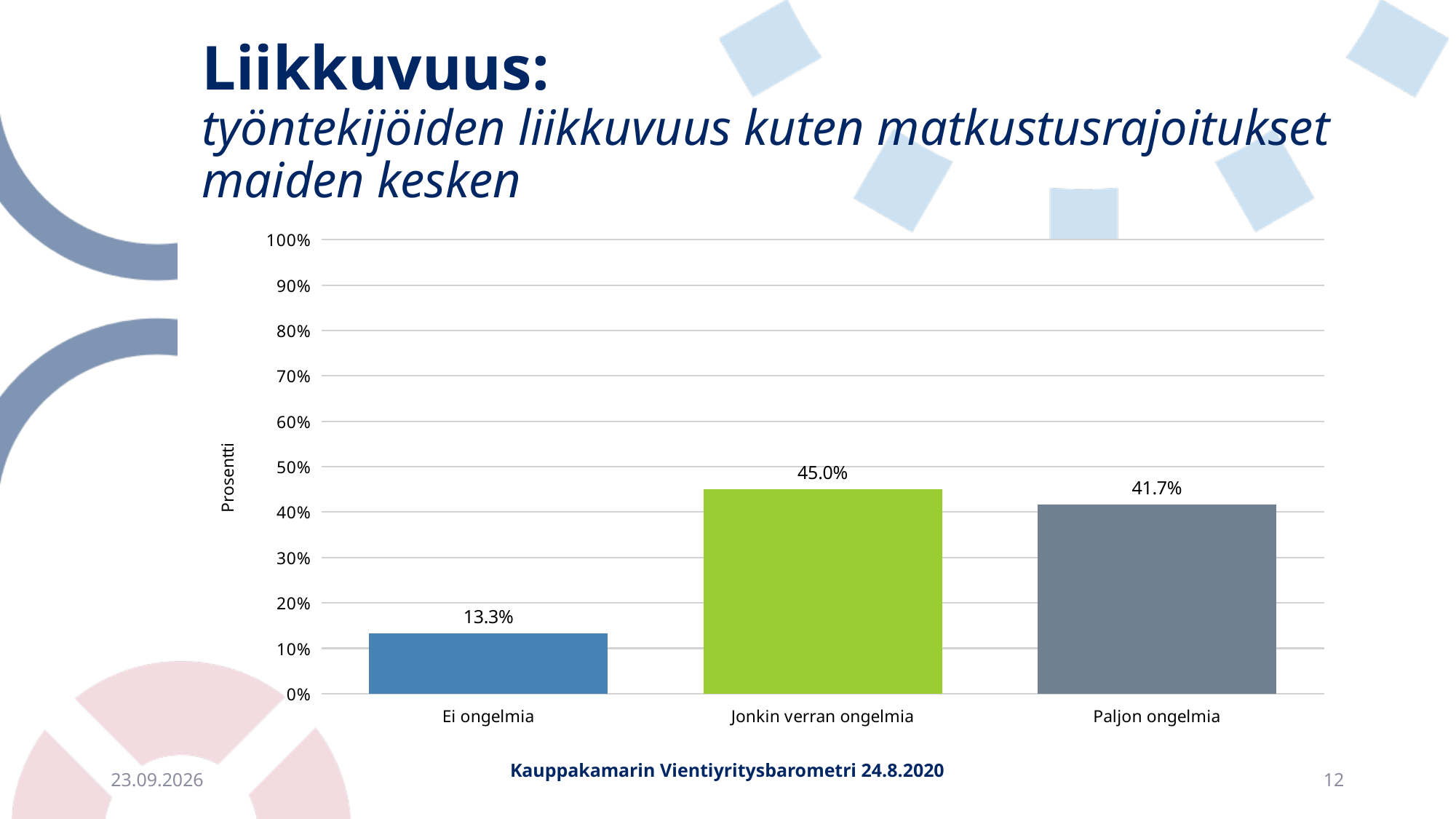
Is the value for Jonkin verran ongelmia greater or less than 50%? less Which is larger, the value for Ei ongelmia or the value for Paljon ongelmia? Paljon ongelmia How many categories are shown on the x axis? 3 What is the value for Ei ongelmia? 13.3% What is the label of the vertical axis? Prosentti What is the difference between the values for Jonkin verran ongelmia and Paljon ongelmia? 3.3% Which category has the highest value? Jonkin verran ongelmia What is the difference between the values for Paljon ongelmia and Ei ongelmia? 28.4% What is the value for Jonkin verran ongelmia? 45.0% What kind of chart is shown on the slide? bar chart What is the value for Paljon ongelmia? 41.7% Which category has the lowest value? Ei ongelmia